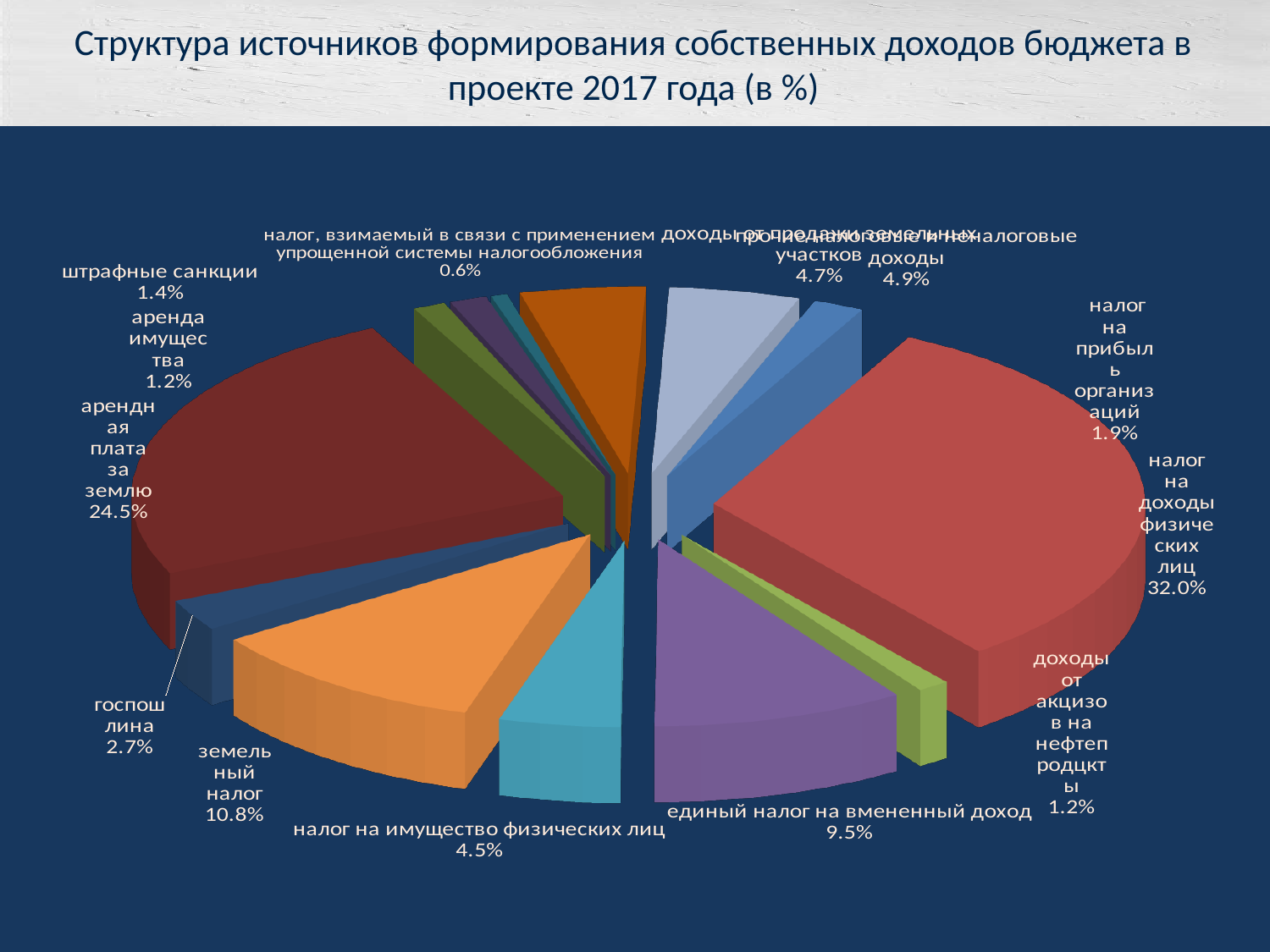
Which category has the smallest share of the pie? налог, взимаемый в связи с применением упрощенной системы налогообложения What is the value for арендная плата за землю? 24.5% What is the value for госпошлина? 2.7% How many categories are shown in the pie chart? 13 What share of the pie is налог на доходы физических лиц? 32.0% What kind of chart is shown on the slide? pie chart Which is larger: земельный налог or единый налог на вмененный доход? земельный налог What is the value for земельный налог? 10.8% What is the value for единый налог на вмененный доход? 9.5% What is the value for налог на имущество физических лиц? 4.5% Which category has the largest share of the pie? налог на доходы физических лиц What is the difference between налог на доходы физических лиц and арендная плата за землю? 7.5%